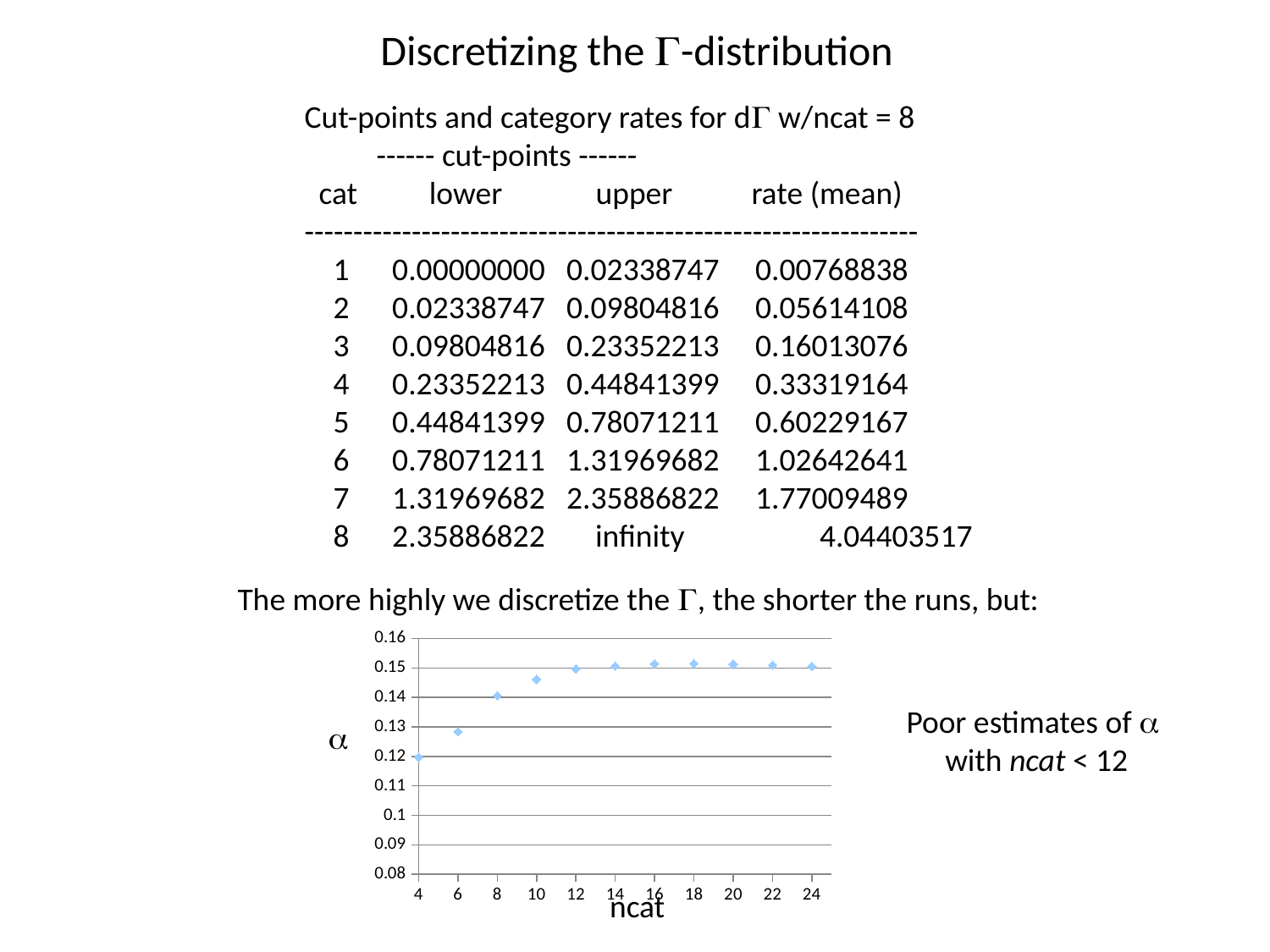
What is the label on the x axis of the chart? ncat Is the value of α at ncat = 20 greater or less than 0.14? greater What is the highest value shown on the y axis of the chart? 0.16 Is the value of α at ncat = 6 greater or less than 0.13? less At which value of ncat is the plotted α lowest? 4 Is the value of α at ncat = 4 greater or less than 0.13? less How many data points are plotted in the chart? 11 How does α change as ncat increases from 4 to 12? it rises What is the label on the y axis of the chart? α Which has the larger α value, ncat = 6 or ncat = 8? ncat = 8 What kind of chart is shown at the bottom of the slide? scatter plot